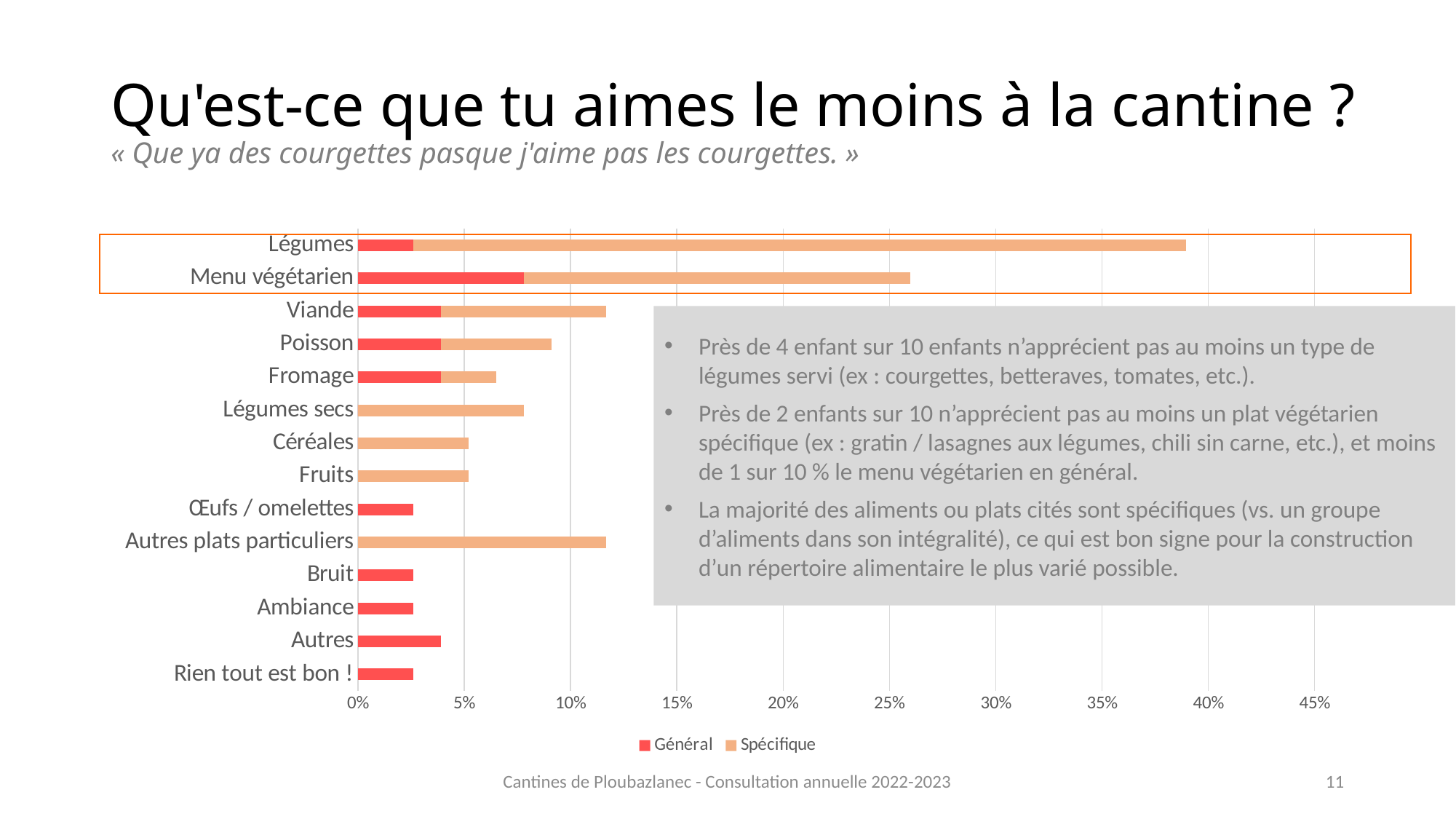
How many categories are listed on the chart's vertical axis? 14 How many series does the chart legend list? 2 What kind of chart is shown on the slide? bar chart Is the total bar for Légumes greater or less than 35%? greater Which category has the longest bar overall? Légumes Which has the longer bar, Autres plats particuliers or Autres? Autres plats particuliers Is the total bar for Viande greater or less than 10%? greater Which has the longer total bar, Viande or Poisson? Viande Is the total bar for Menu végétarien greater or less than 20%? greater Which series is shown in red in the legend? Général